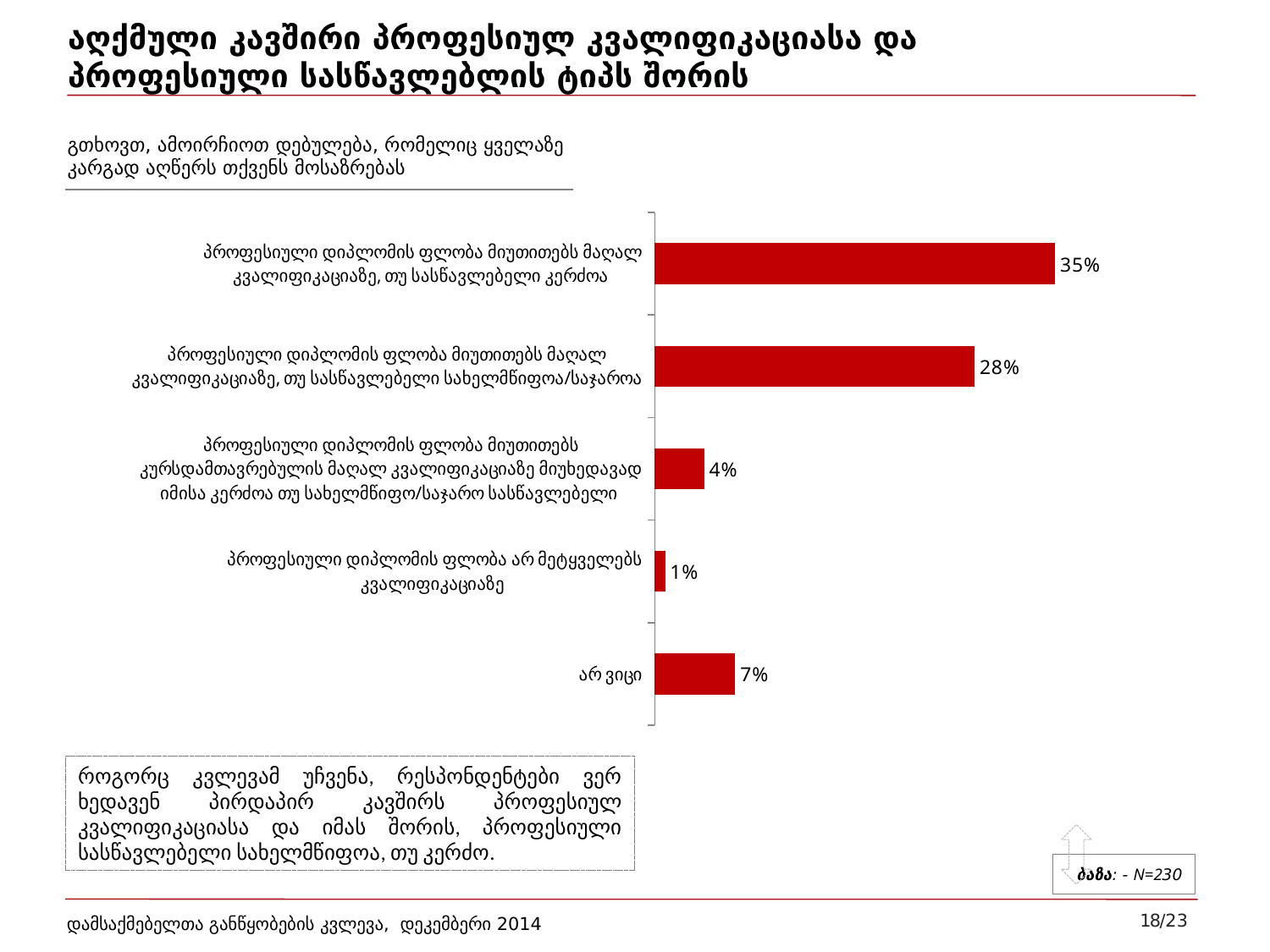
What value is shown for "პროფესიული დიპლომის ფლობა არ მეტყველებს კვალიფიკაციაზე"? 1% Which is larger: the value for "არ ვიცი" or the value for the statement about a diploma indicating high qualification regardless of institution type? არ ვიცი What value is shown for "პროფესიული დიპლომის ფლობა მიუთითებს მაღალ კვალიფიკაციაზე, თუ სასწავლებელი კერძოა"? 35% What percentage is shown for the bar "არ ვიცი"? 7% What is the sample size (N) noted on the slide? N=230 What colour are the bars in the chart? Red What is the difference between the value for the private-institution statement (35%) and the state/public-institution statement (28%)? 7% Which category has the lowest value in the chart? პროფესიული დიპლომის ფლობა არ მეტყველებს კვალიფიკაციაზე What type of chart is shown on the slide? Bar chart Which category has the highest value in the chart? პროფესიული დიპლომის ფლობა მიუთითებს მაღალ კვალიფიკაციაზე, თუ სასწავლებელი კერძოა What value is shown for "პროფესიული დიპლომის ფლობა მიუთითებს მაღალ კვალიფიკაციაზე, თუ სასწავლებელი სახელმწიფოა/საჯაროა"? 28% How many bars are plotted in the chart? 5